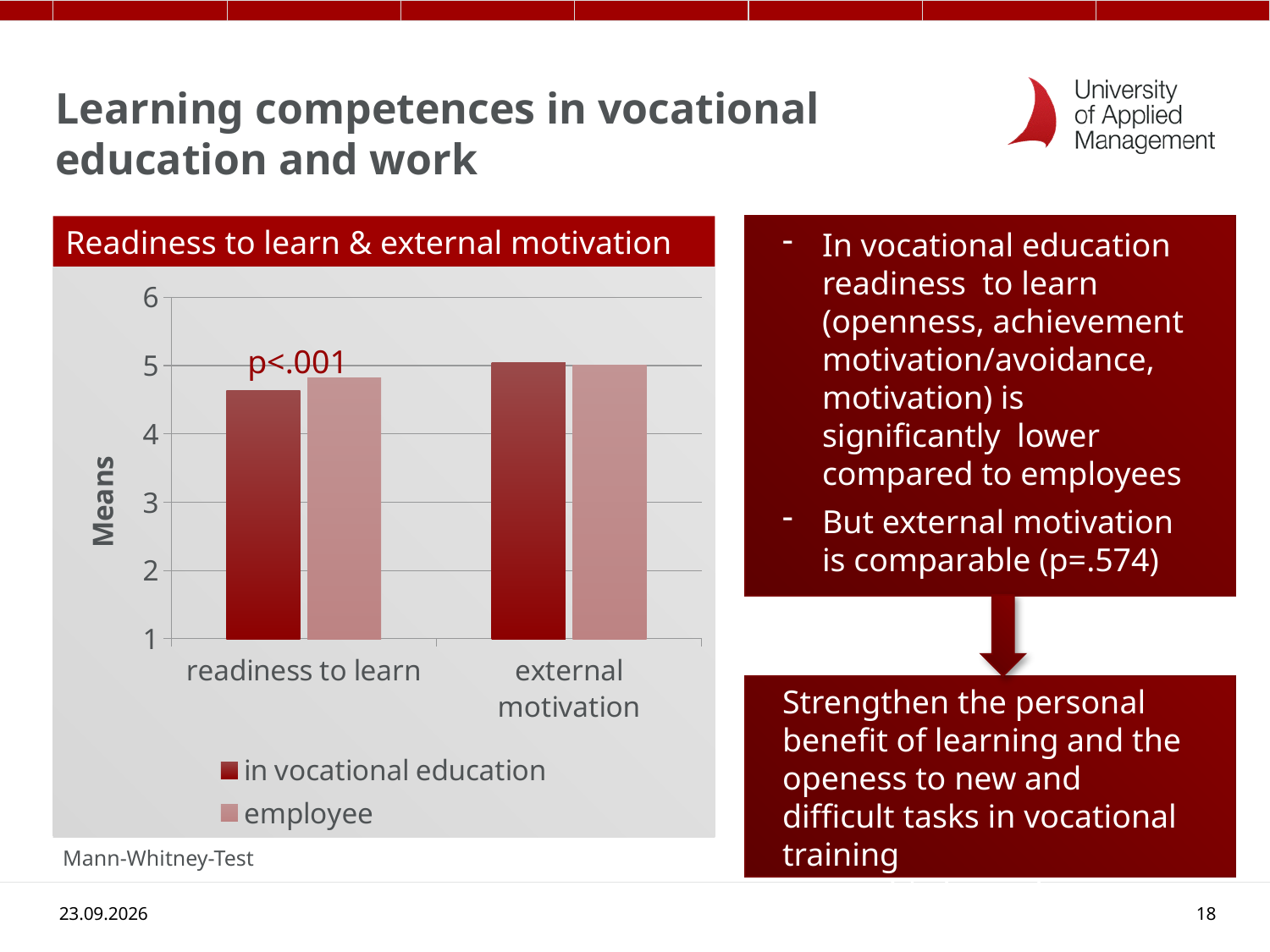
Is the value for "employee" in the external motivation category greater or less than 6? less Is the value for "in vocational education" in the readiness to learn category greater or less than 5? less How many categories are shown on the x axis of the chart? 2 Is the value for "in vocational education" in the external motivation category greater or less than 4? greater How many series does the chart's legend list? 2 For readiness to learn, which series has the higher bar: in vocational education or employee? employee Which series has the lowest bar in the chart, and for which category? in vocational education, readiness to learn What is the label of the chart's y axis? Means What kind of chart is shown under the title "Readiness to learn & external motivation"? bar chart What p-value annotation is printed above the readiness to learn bars? p<.001